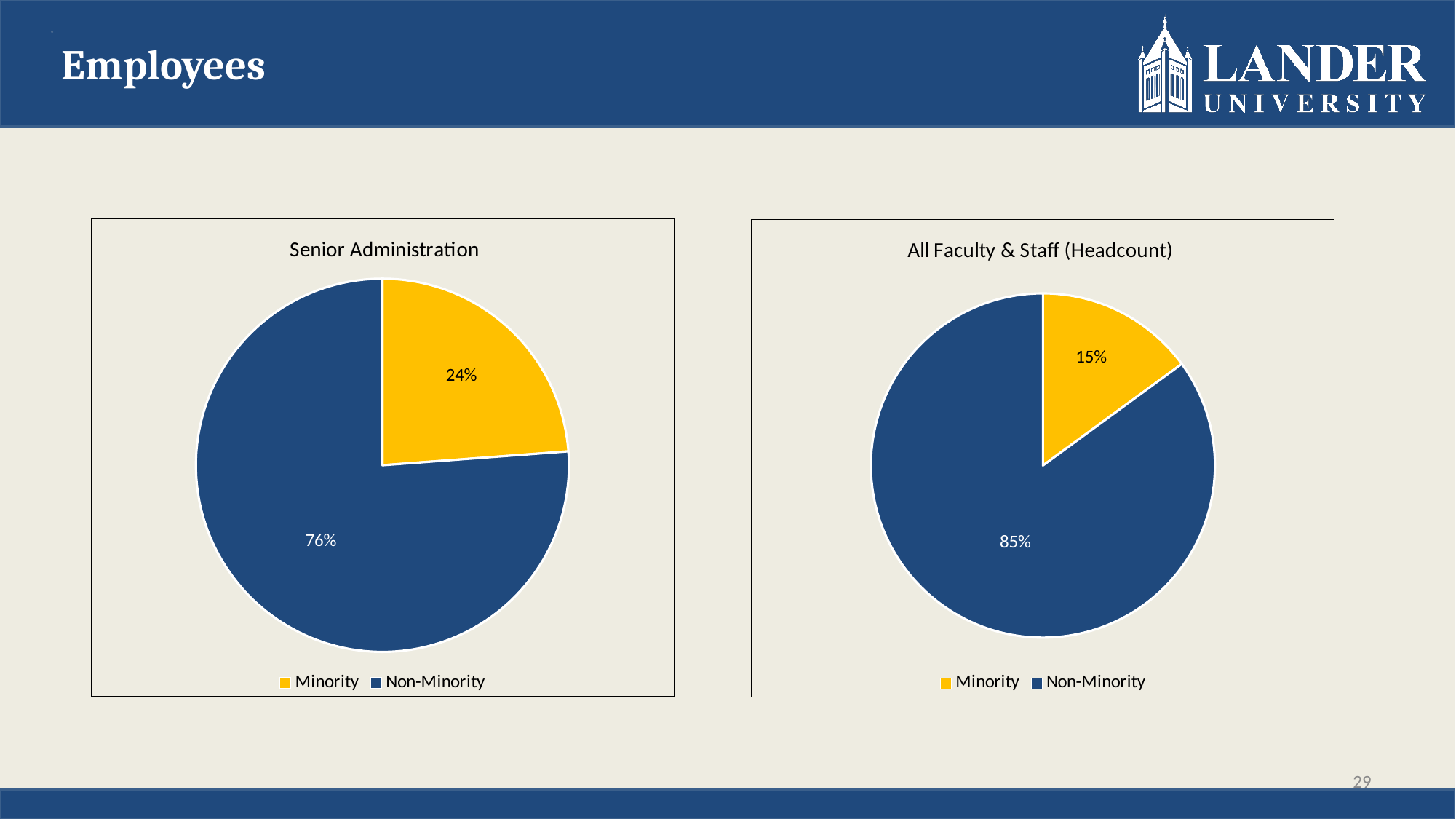
In the Senior Administration chart, what colour is the Minority slice? Yellow In the All Faculty & Staff (Headcount) chart, what is the difference between the Non-Minority and Minority shares? 70% In the All Faculty & Staff (Headcount) chart, what share of the pie is Minority? 15% In the All Faculty & Staff (Headcount) chart, which slice is the smallest? Minority In the All Faculty & Staff (Headcount) chart, what share of the pie is Non-Minority? 85% Which chart has the larger Minority share, Senior Administration or All Faculty & Staff (Headcount)? Senior Administration In the Senior Administration chart, what is the difference between the Non-Minority and Minority shares? 52% In the Senior Administration chart, which slice is the largest? Non-Minority In the Senior Administration chart, what share of the pie is Non-Minority? 76% How many slices does the All Faculty & Staff (Headcount) pie chart have? 2 What kind of chart is the Senior Administration chart? Pie chart